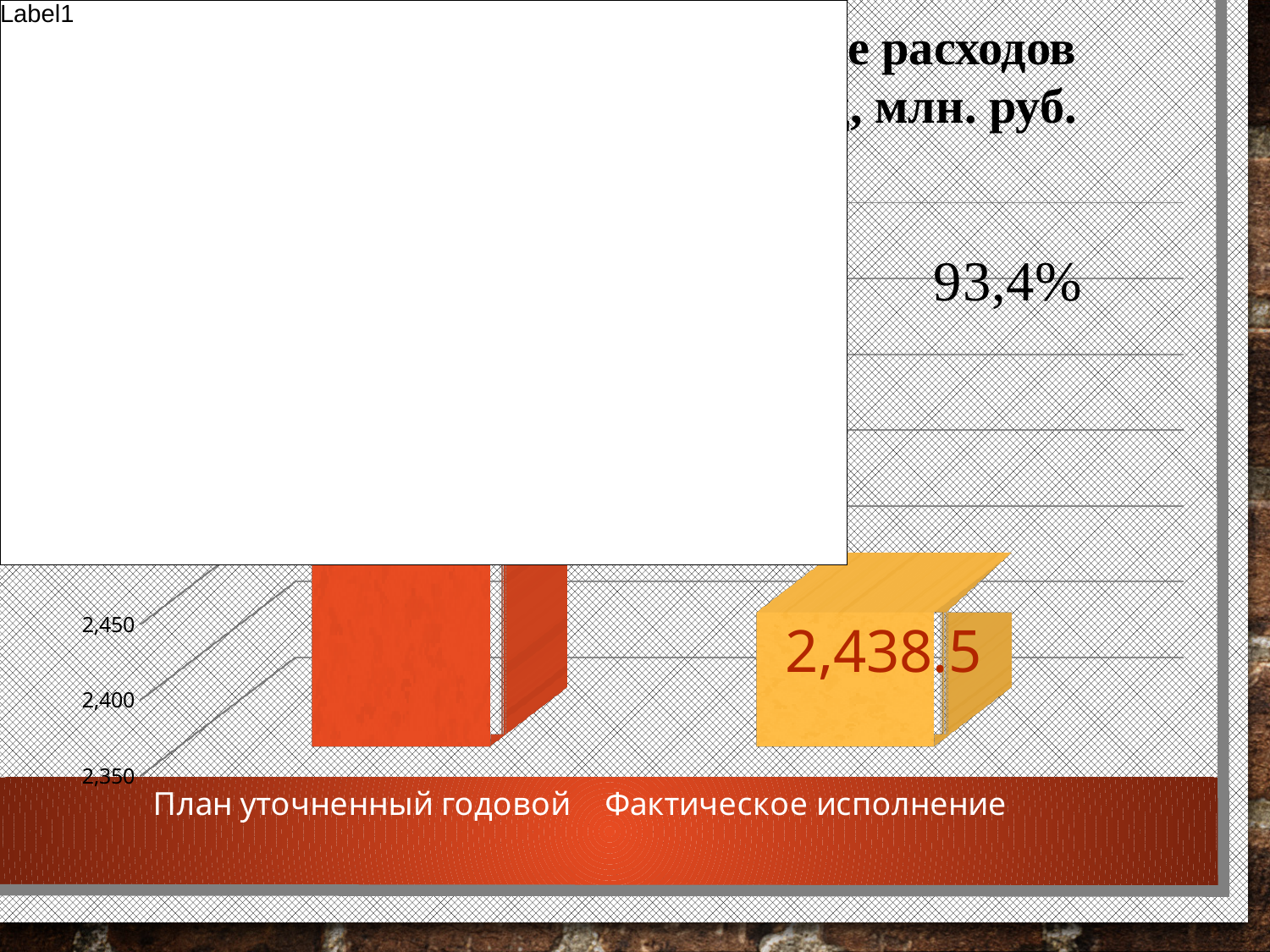
What colour is the bar for Фактическое исполнение? yellow Is the value for Фактическое исполнение greater or less than 2,400? greater Which category has the highest value in the chart? План уточненный годовой What percentage is printed on the chart? 93,4% Which category has the higher bar, План уточненный годовой or Фактическое исполнение? План уточненный годовой What is the value for Фактическое исполнение? 2,438.5 What kind of chart is shown on the slide? bar chart How many categories are shown on the x axis of the chart? 2 Is the value for План уточненный годовой greater or less than 2,450? greater Which category has the lowest value in the chart? Фактическое исполнение Is the value for Фактическое исполнение greater or less than 2,450? less